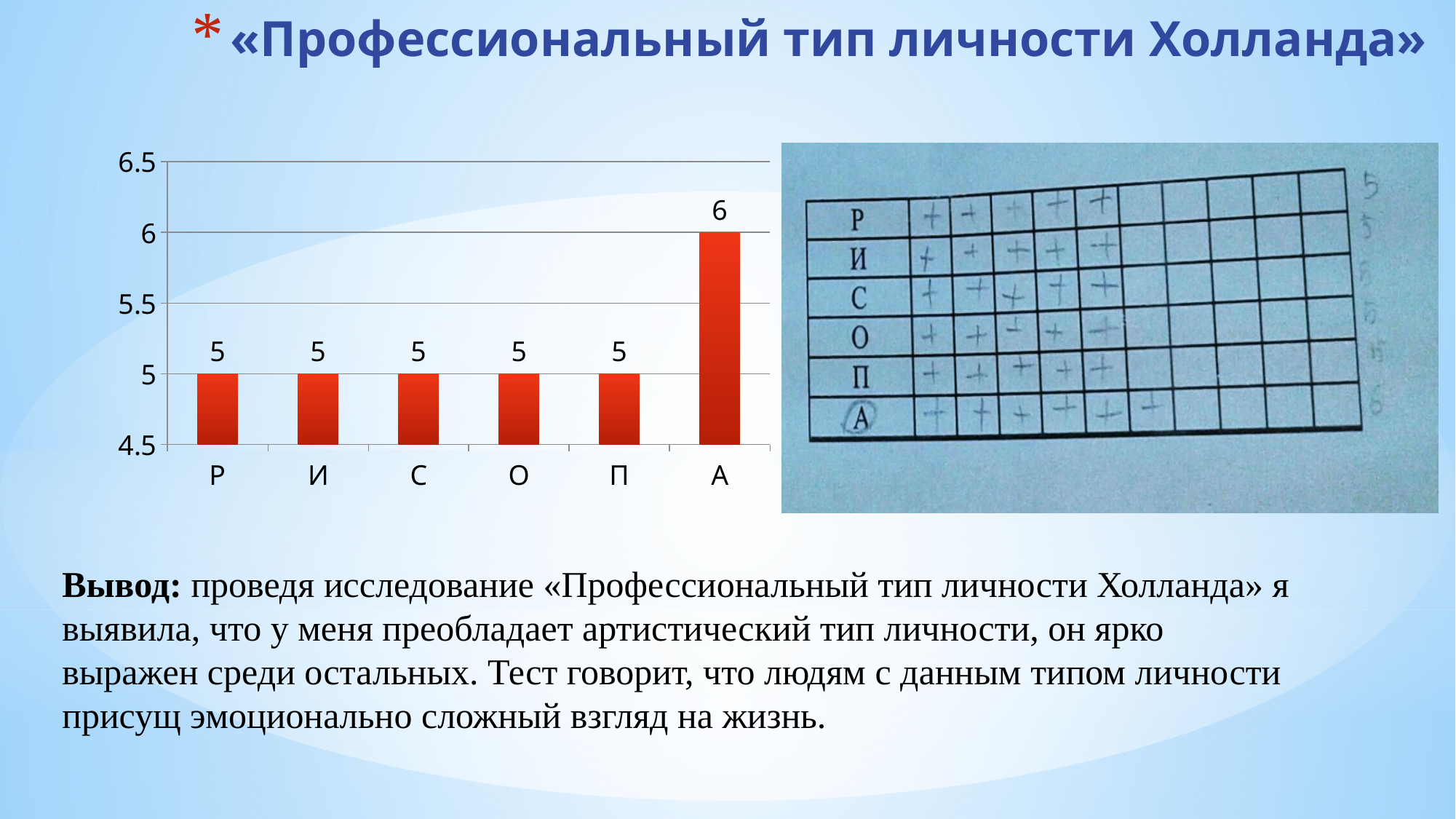
How many categories in the bar chart have a value of 5? 5 What is the difference between the values for А and П in the bar chart? 1 Is the value for О in the bar chart greater or less than 5.5? less What colour are the bars in the bar chart? red What is the value for category А in the bar chart? 6 Which category has the highest value in the bar chart? А Is the value for А in the bar chart greater or less than 5.5? greater How many categories are shown in the bar chart? 6 Which is larger in the bar chart, the value for А or the value for И? А What is the value for category Р in the bar chart? 5 What kind of chart is shown on the left of the slide? bar chart What is the value for category С in the bar chart? 5